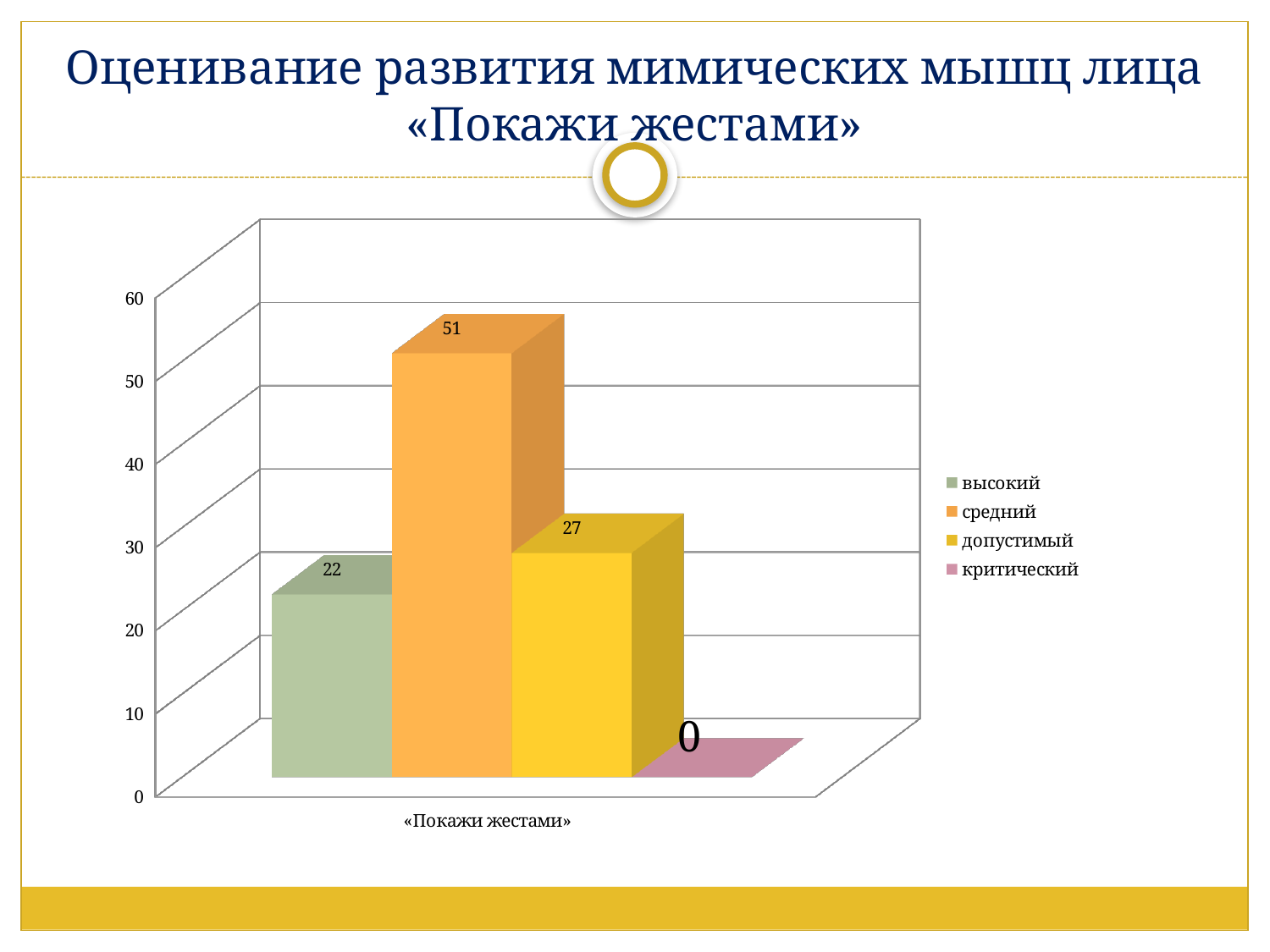
What is the difference between the values for «допустимый» and «высокий»? 5 What is the value for the series «критический»? 0 Which series has the lowest value? критический What kind of chart is shown on the slide? bar chart Which series has the highest value? средний Is the value for «средний» greater or less than 40? greater What is the value for the series «высокий»? 22 How many series does the legend list? 4 What is the value for the series «средний»? 51 Which is larger, the value for «высокий» or the value for «допустимый»? допустимый What is the value for the series «допустимый»? 27 What is the difference between the values for «средний» and «допустимый»? 24